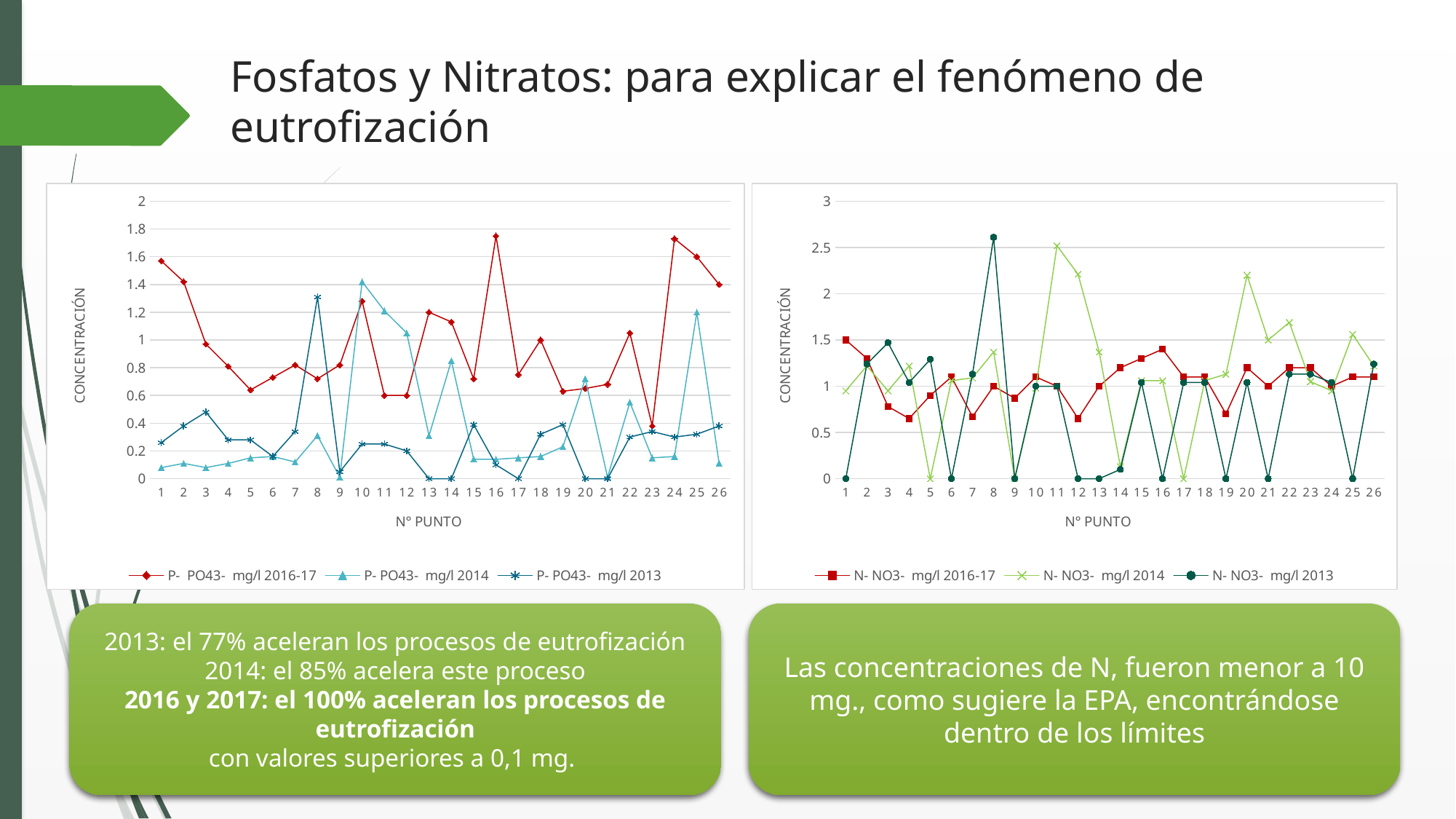
In the right chart, is the value of N- NO3- mg/l 2013 at point 8 greater or less than 2.5? greater In the left chart, at point 16, which series has the larger value: P- PO43- mg/l 2016-17 or P- PO43- mg/l 2014? P- PO43- mg/l 2016-17 In the right chart, is the value of N- NO3- mg/l 2016-17 at point 4 greater or less than 1? less In the left chart, is the value of P- PO43- mg/l 2016-17 at point 16 greater or less than 1.6? greater How many points (N° PUNTO) are shown along the x axis of the left chart? 26 How many series does the legend of the right chart list? 3 In the right chart, what is the value of N- NO3- mg/l 2013 at point 9? 0 What kind of chart is the left chart on the slide? line chart What is the x-axis title of the right chart? N° PUNTO In the right chart, at point 11, which series has the larger value: N- NO3- mg/l 2014 or N- NO3- mg/l 2016-17? N- NO3- mg/l 2014